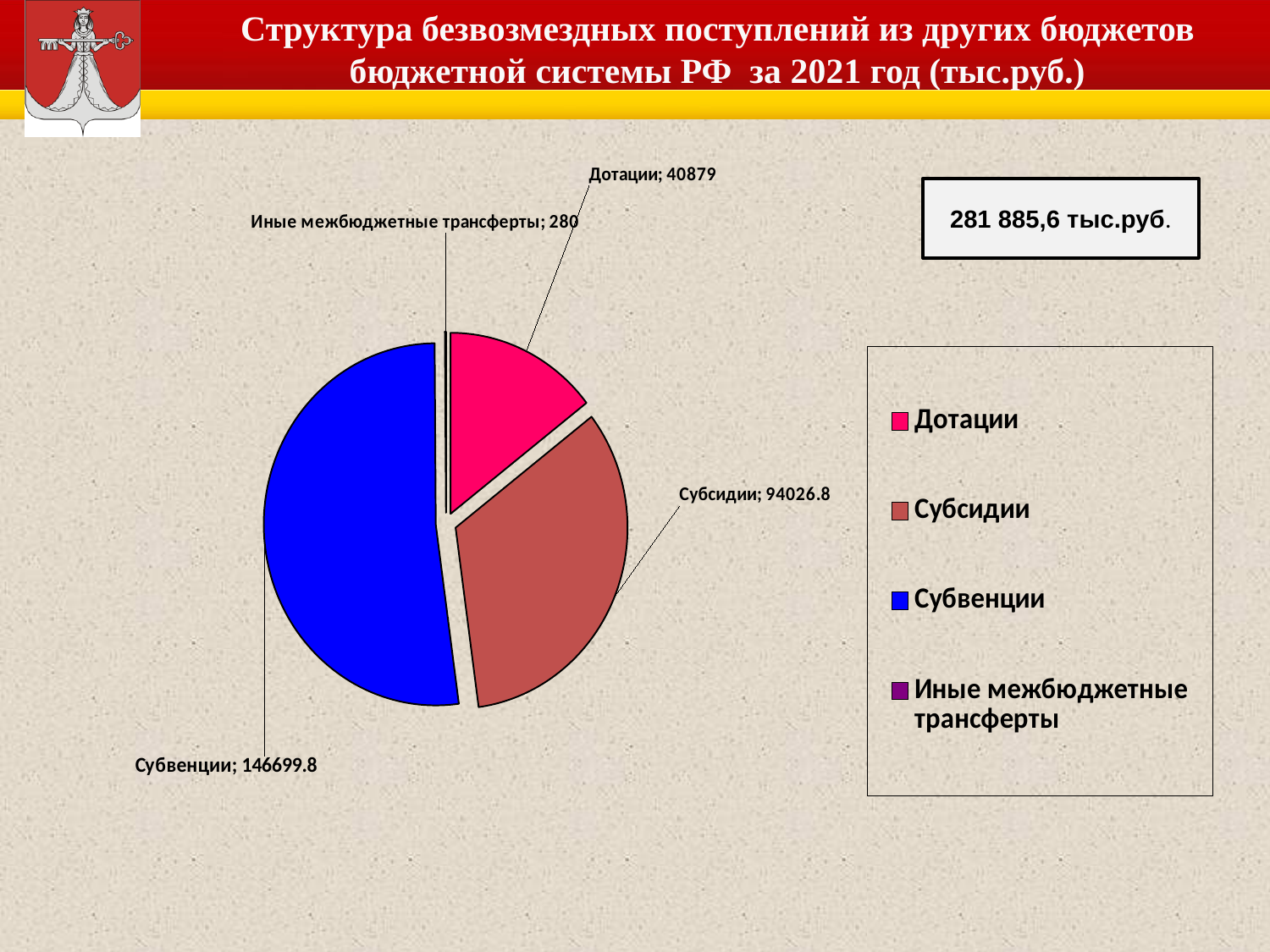
What is the difference between the values for Субсидии and Дотации? 53147.8 What is the value for Иные межбюджетные трансферты? 280 Which category has the smallest slice of the pie? Иные межбюджетные трансферты What type of chart is shown on the slide? Pie chart Which is larger, the value for Дотации or the value for Субсидии? Субсидии What is the difference between the values for Субвенции and Субсидии? 52673 What is the value for Субсидии? 94026.8 Which category has the largest slice of the pie? Субвенции What is the value for Субвенции? 146699.8 What colour is the Субвенции slice? Blue What is the value for Дотации? 40879 How many categories does the pie chart have? 4